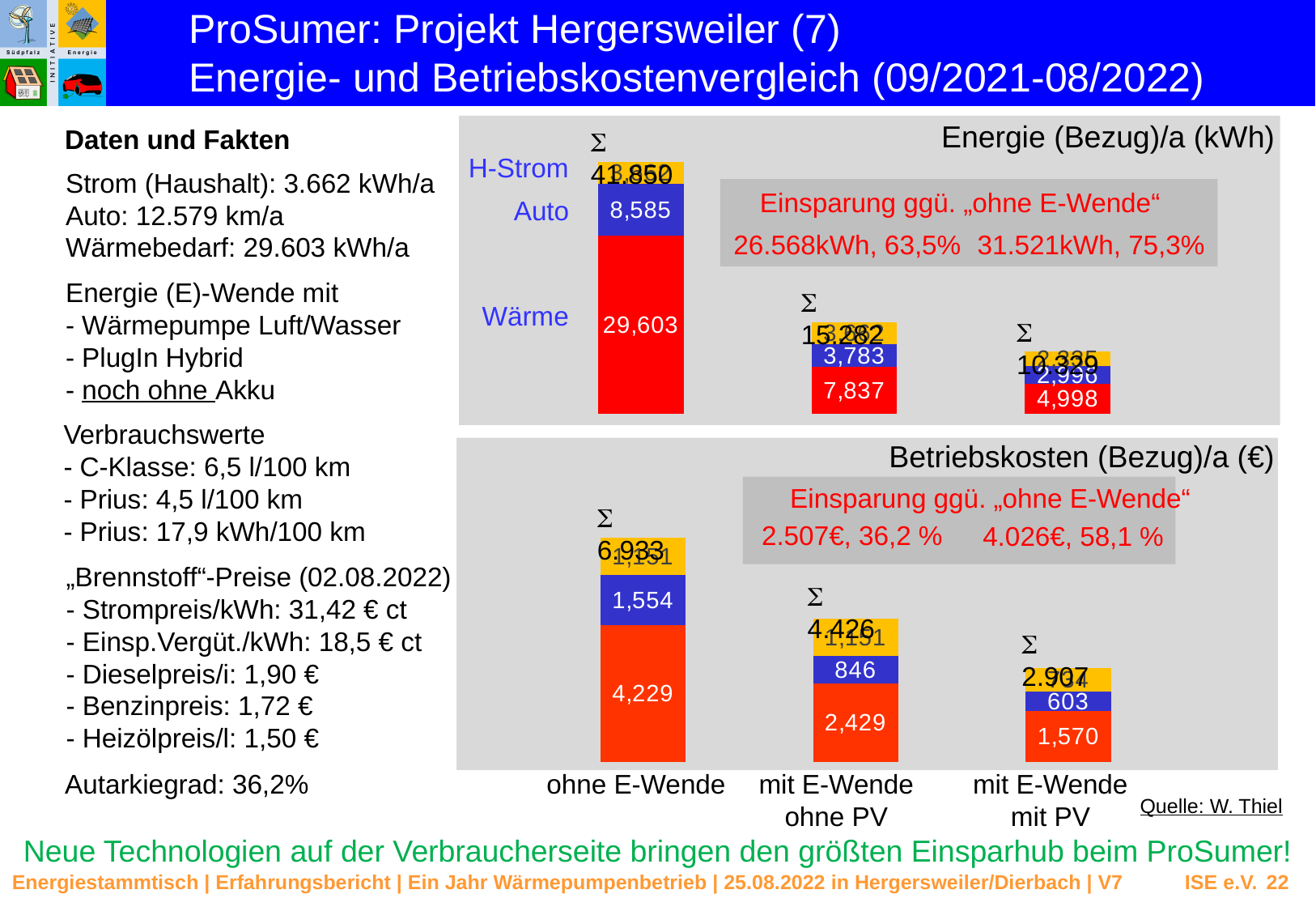
In the Energie (Bezug)/a (kWh) chart, which is larger: the Auto value for "ohne E-Wende" or for "mit E-Wende mit PV"? ohne E-Wende In the Energie (Bezug)/a (kWh) chart, what is the Auto value for "mit E-Wende ohne PV"? 3,783 In the Betriebskosten (Bezug)/a (€) chart, what is the difference between the Wärme values for "ohne E-Wende" and "mit E-Wende mit PV"? 2,659 In the Betriebskosten (Bezug)/a (€) chart, which category has the highest Wärme value? ohne E-Wende In the Energie (Bezug)/a (kWh) chart, what is the difference between the Wärme values for "ohne E-Wende" and "mit E-Wende ohne PV"? 21,766 What kind of chart is the Betriebskosten (Bezug)/a (€) chart? Stacked bar chart In the Betriebskosten (Bezug)/a (€) chart, what is the Auto value for "mit E-Wende mit PV"? 603 In the Betriebskosten (Bezug)/a (€) chart, what is the Wärme value for "ohne E-Wende"? 4,229 In the Betriebskosten (Bezug)/a (€) chart, what is the Auto value for "mit E-Wende ohne PV"? 846 How many categories are shown along the x axis of the Energie (Bezug)/a (kWh) chart? 3 In the Energie (Bezug)/a (kWh) chart, what is the Wärme value for "mit E-Wende mit PV"? 4,998 In the Energie (Bezug)/a (kWh) chart, what is the Wärme value for "ohne E-Wende"? 29,603